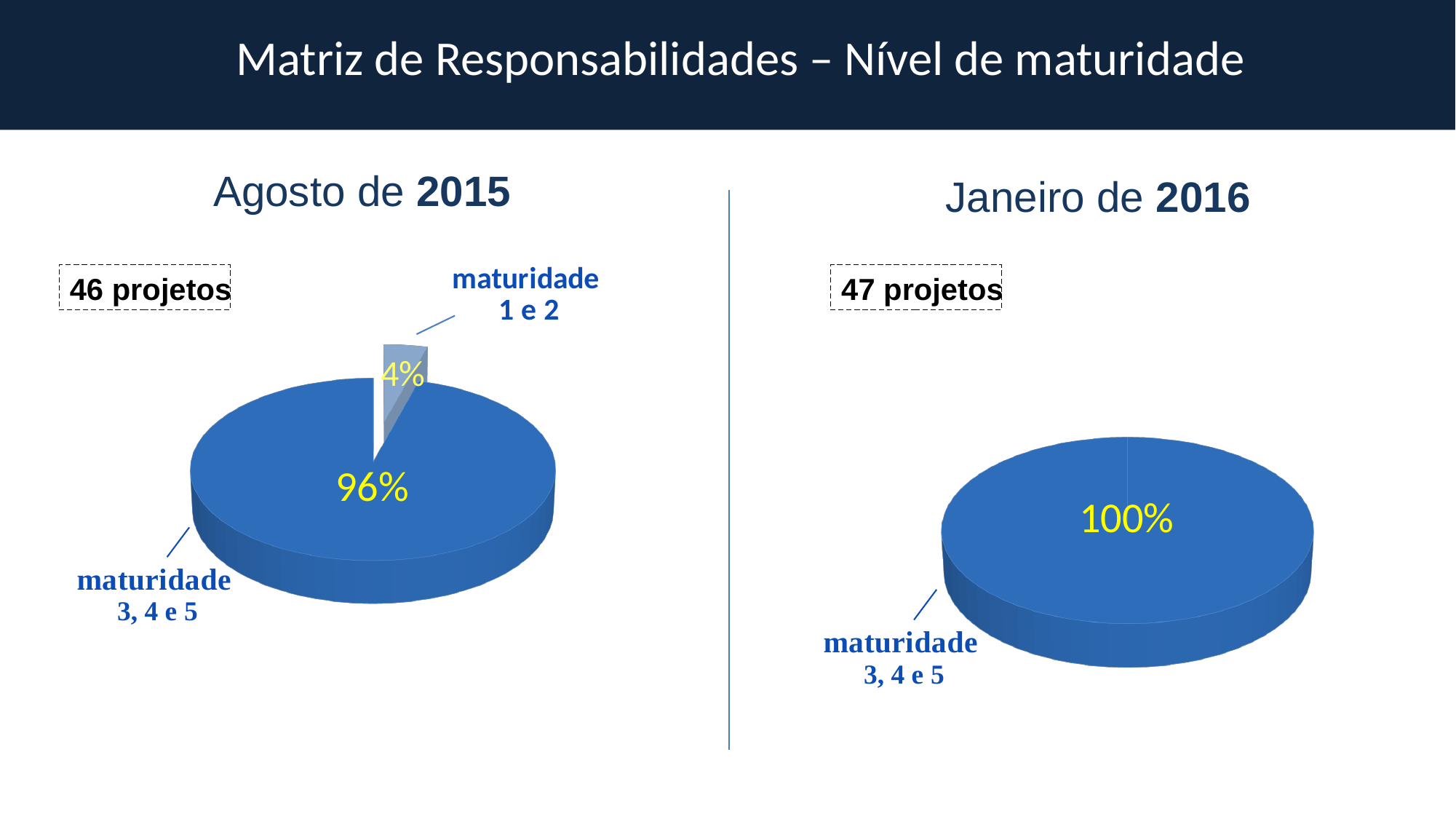
How many slices does the Janeiro de 2016 pie chart have? 1 How many projects are indicated for the Agosto de 2015 chart? 46 projetos In the Agosto de 2015 chart, which slice is larger: 'maturidade 1 e 2' or 'maturidade 3, 4 e 5'? maturidade 3, 4 e 5 In the Agosto de 2015 chart, which slice is the largest? maturidade 3, 4 e 5 In the Agosto de 2015 chart, what is the difference between the 'maturidade 3, 4 e 5' share and the 'maturidade 1 e 2' share? 92% In the Agosto de 2015 chart, what share of the pie is labelled 'maturidade 3, 4 e 5'? 96% What kind of chart is shown under Agosto de 2015? Pie chart In the Agosto de 2015 chart, what share of the pie is labelled 'maturidade 1 e 2'? 4% In the Janeiro de 2016 chart, what share of the pie is labelled 'maturidade 3, 4 e 5'? 100% In the Agosto de 2015 chart, which slice is the smallest? maturidade 1 e 2 How many projects are indicated for the Janeiro de 2016 chart? 47 projetos How many slices does the Agosto de 2015 pie chart have? 2